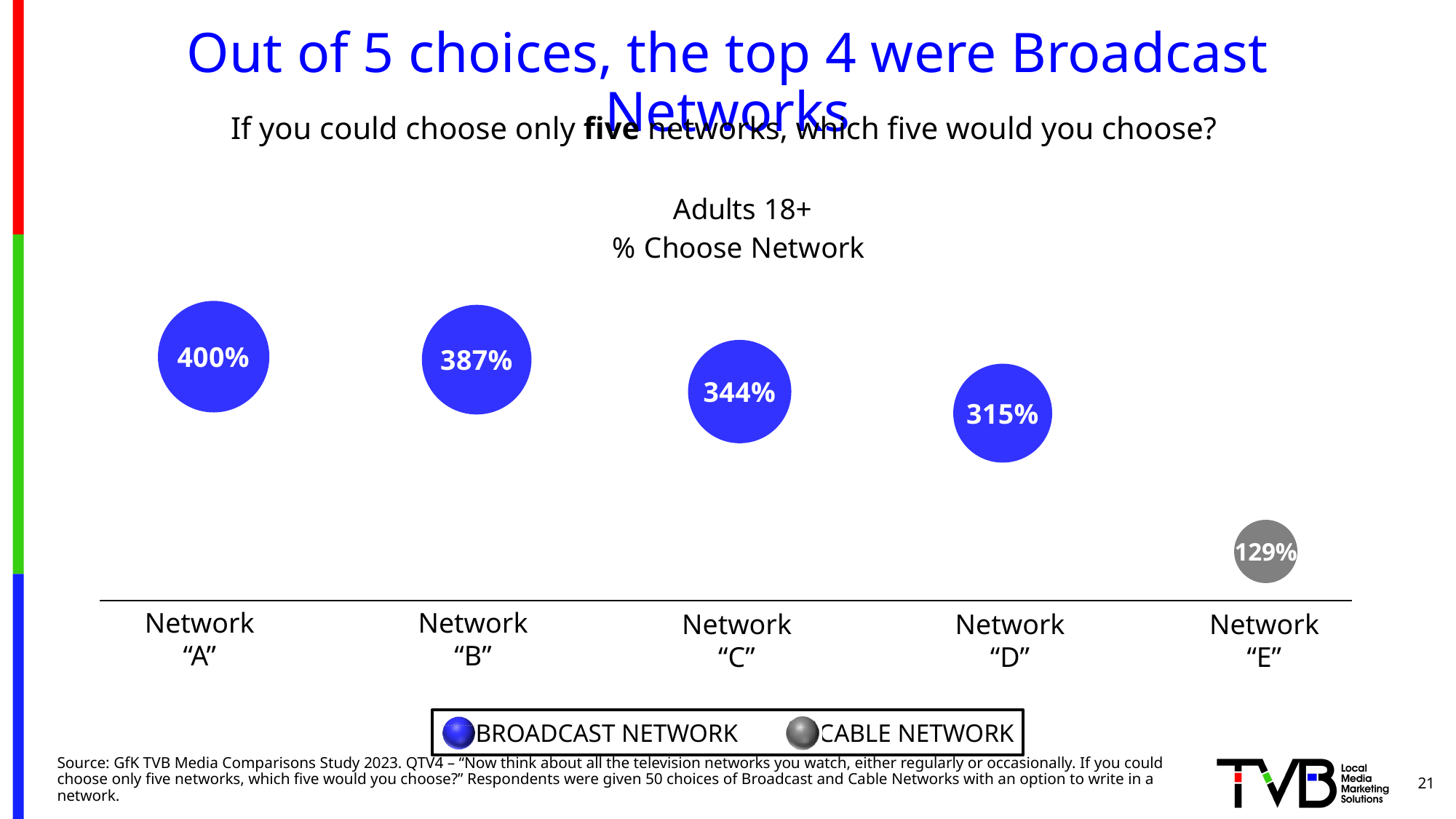
What is the value shown for Network "A"? 400% Which network has the lowest value? Network "E" How many networks are shown on the chart? 5 Which network is shown as a Cable Network in the chart? Network "E" Do the values rise or fall moving from Network "A" to Network "E"? fall Which has a larger value, Network "C" or Network "D"? Network "C" What is the value shown for Network "E"? 129% Which network has the highest value? Network "A" What is the difference between the values for Network "A" and Network "B"? 13% What is the value shown for Network "C"? 344% How many entries does the legend list? 2 What is the difference between the values for Network "D" and Network "E"? 186%